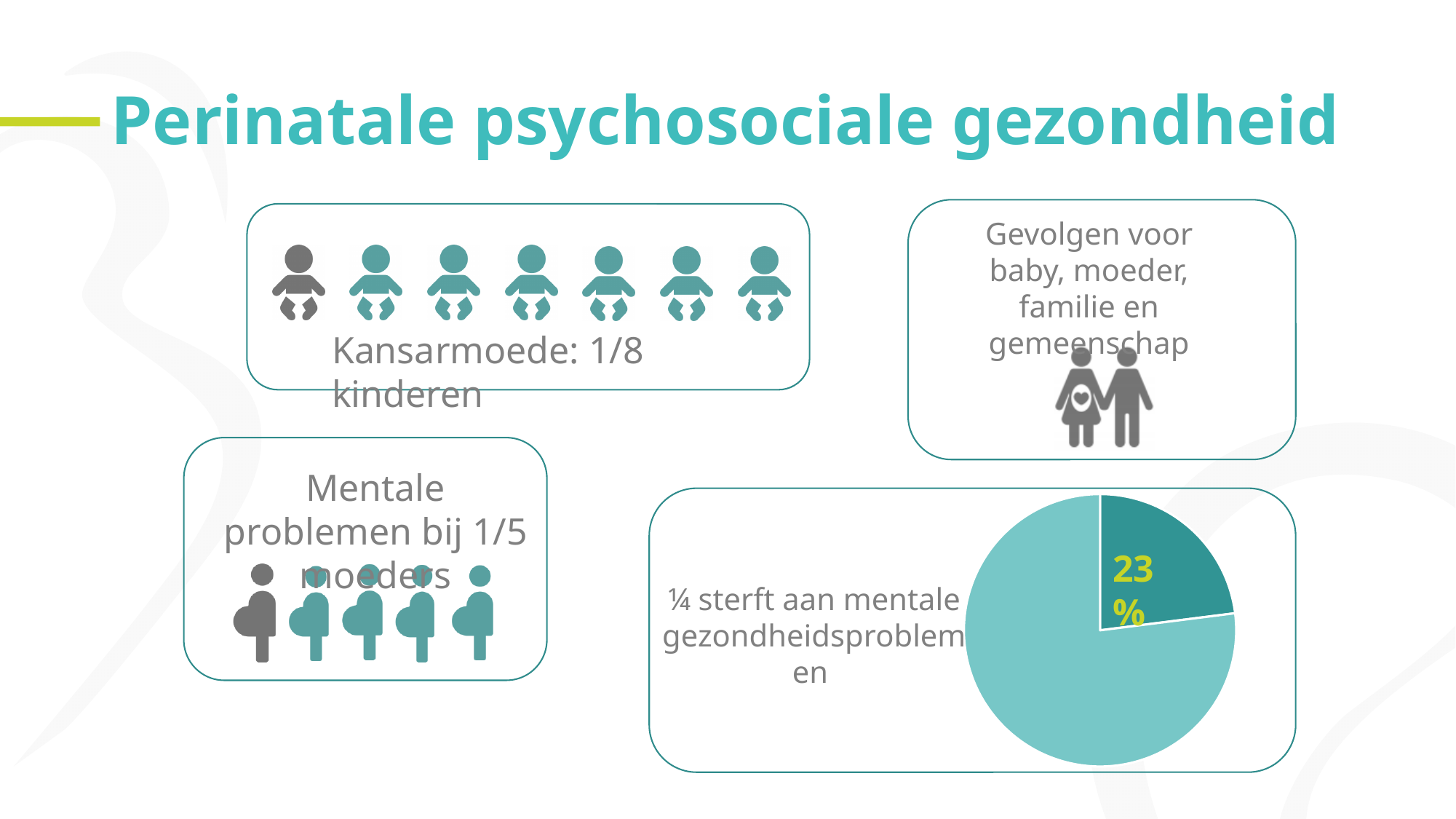
What colour is the slice labelled 23% in the pie chart? dark teal In the pie chart, which slice is larger: the dark teal slice labelled 23% or the light teal unlabelled slice? the light teal unlabelled slice Is the labelled slice of the pie chart greater or less than half of the pie? less What kind of chart is shown in the bottom-right box of the slide? pie chart In the pie chart, what value is printed on the labelled slice? 23% How many slices does the pie chart have? 2 What text accompanies the pie chart in the bottom-right box? ¼ sterft aan mentale gezondheidsproblemen In the pie chart, which slice is the smallest? the dark teal slice labelled 23%